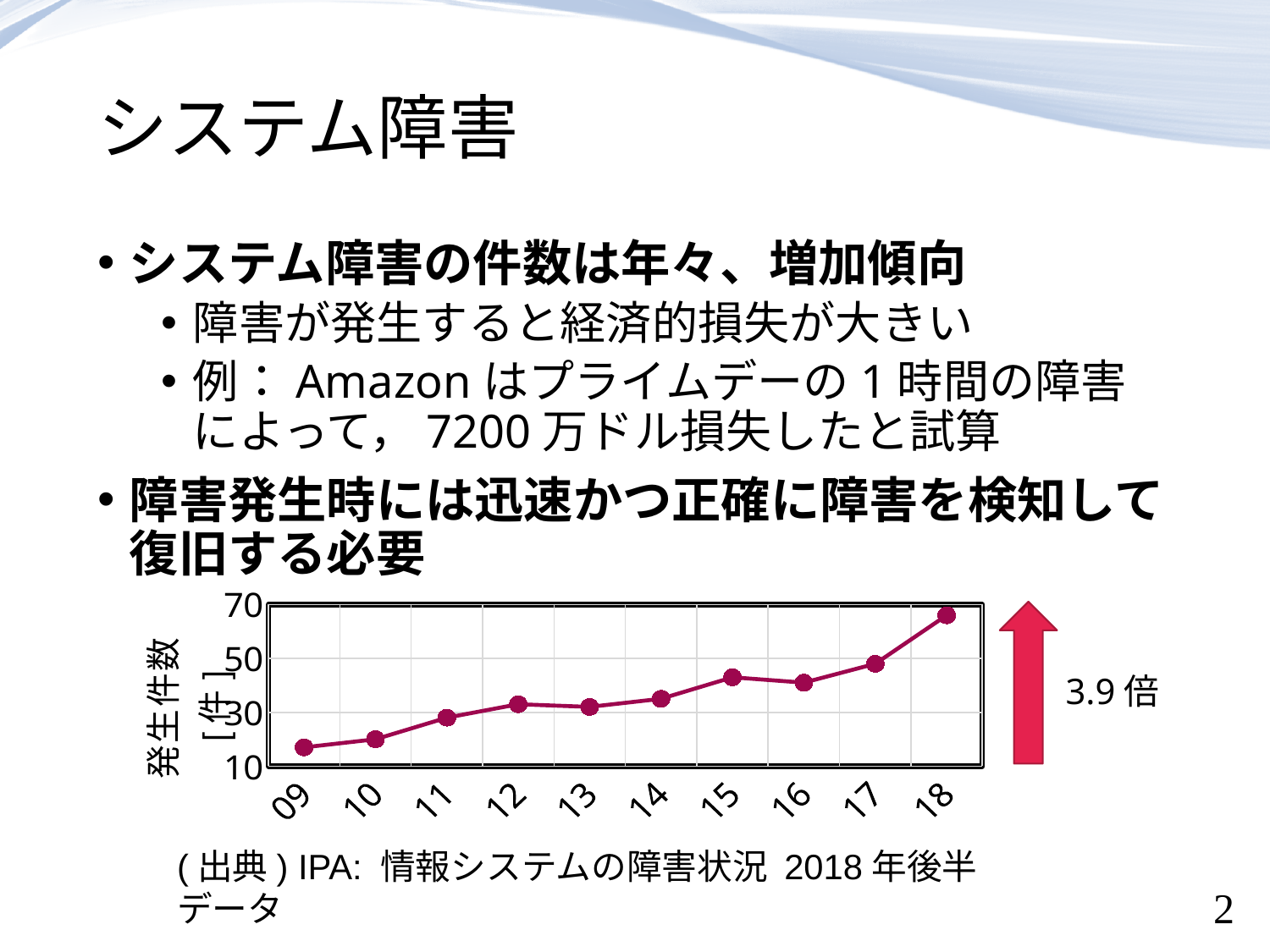
What kind of chart is shown on the slide? line chart Do the values on the line chart generally rise or fall from 09 to 18? rise Is the value for 09 greater or less than 30? less Which year has the highest value on the line chart? 18 What multiplier is written next to the red arrow beside the chart? 3.9 倍 Is the value for 18 greater or less than 50? greater How many data points are plotted on the line chart? 10 What is the label on the y axis of the line chart? 発生件数 [件] Is the value for 15 greater or less than 30? greater Which is larger, the value for 17 or the value for 18? 18 Which year has the lowest value on the line chart? 09